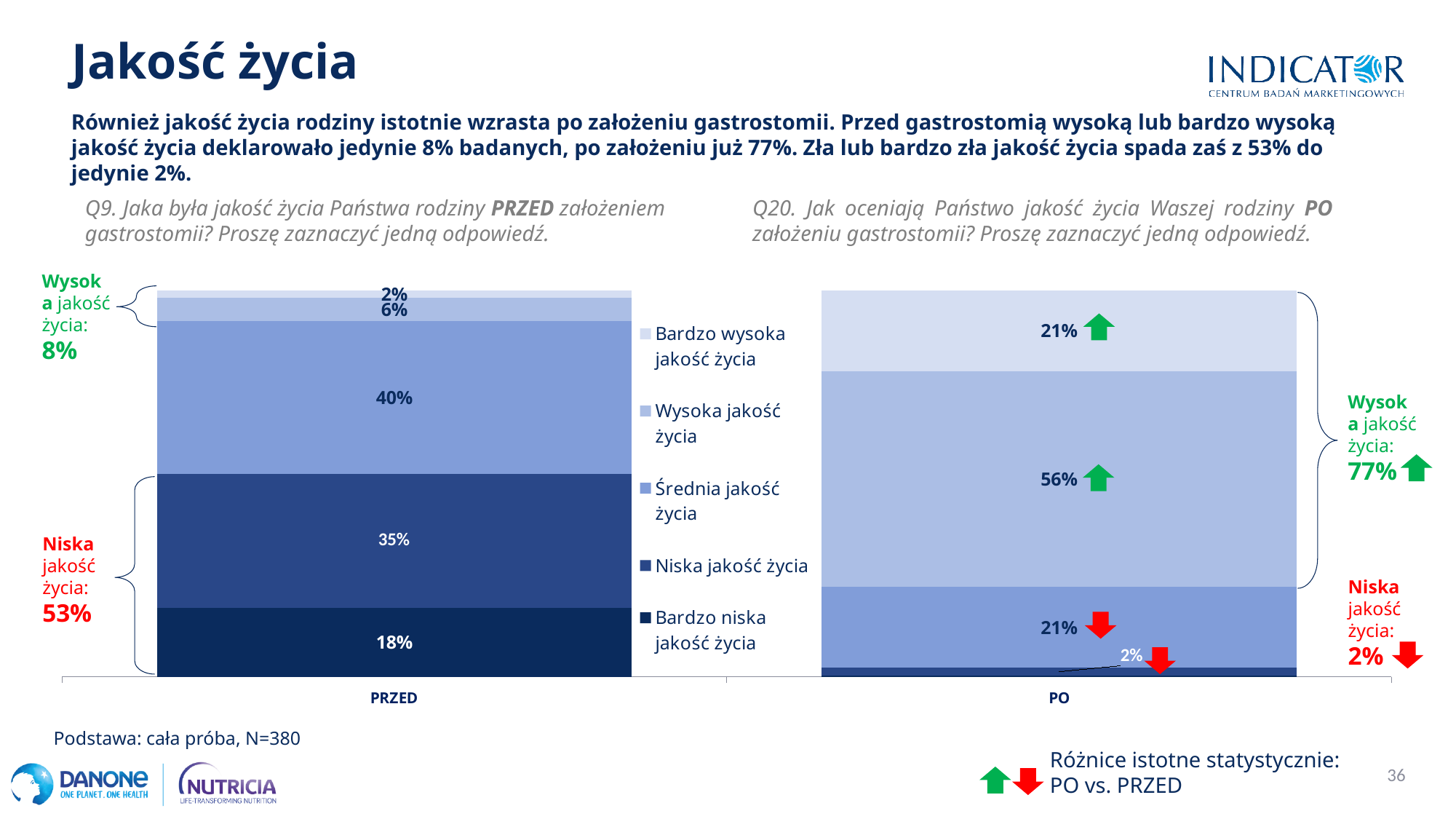
What is the value for Bardzo niska jakość życia in the PRZED bar? 18% What kind of chart is shown on the slide? Stacked bar chart What is the value for Bardzo wysoka jakość życia in the PRZED bar? 2% Which bar has the larger value for Wysoka jakość życia, PRZED or PO? PO What is the value for Średnia jakość życia in the PRZED bar? 40% By how many percentage points does Średnia jakość życia differ between PRZED and PO? 19 percentage points What is the value for Bardzo wysoka jakość życia in the PO bar? 21% What is the value for Wysoka jakość życia in the PO bar? 56% Which segment is the largest in the PRZED bar? Średnia jakość życia How many bars (categories) are shown on the x axis? 2 How many series does the legend list? 5 What is the value for Niska jakość życia in the PRZED bar? 35%